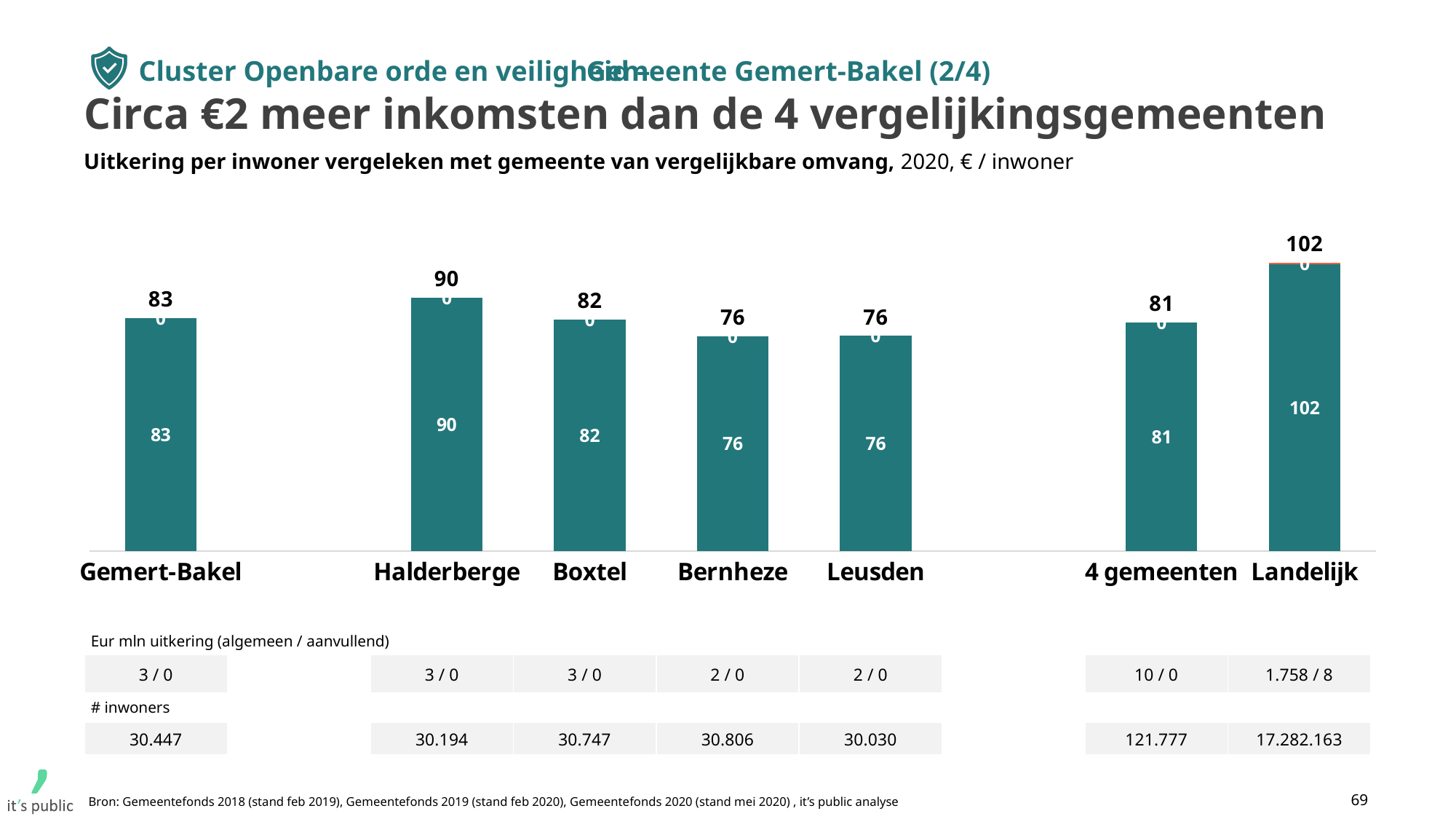
How many bars are shown in the chart? 7 Which category has the highest value? Landelijk What kind of chart is shown on the slide? Bar chart What unit is stated in the chart subtitle for the values? € / inwoner What is the difference between the values for Landelijk and Halderberge? 12 What is the value for Halderberge? 90 What is the value for Landelijk? 102 What is the value for Gemert-Bakel? 83 Which of the four comparison municipalities (Halderberge, Boxtel, Bernheze, Leusden) has the highest value? Halderberge What is the difference between the values for Gemert-Bakel and 4 gemeenten? 2 What is the value for 4 gemeenten? 81 Which is larger, the value for Boxtel or the value for Bernheze? Boxtel